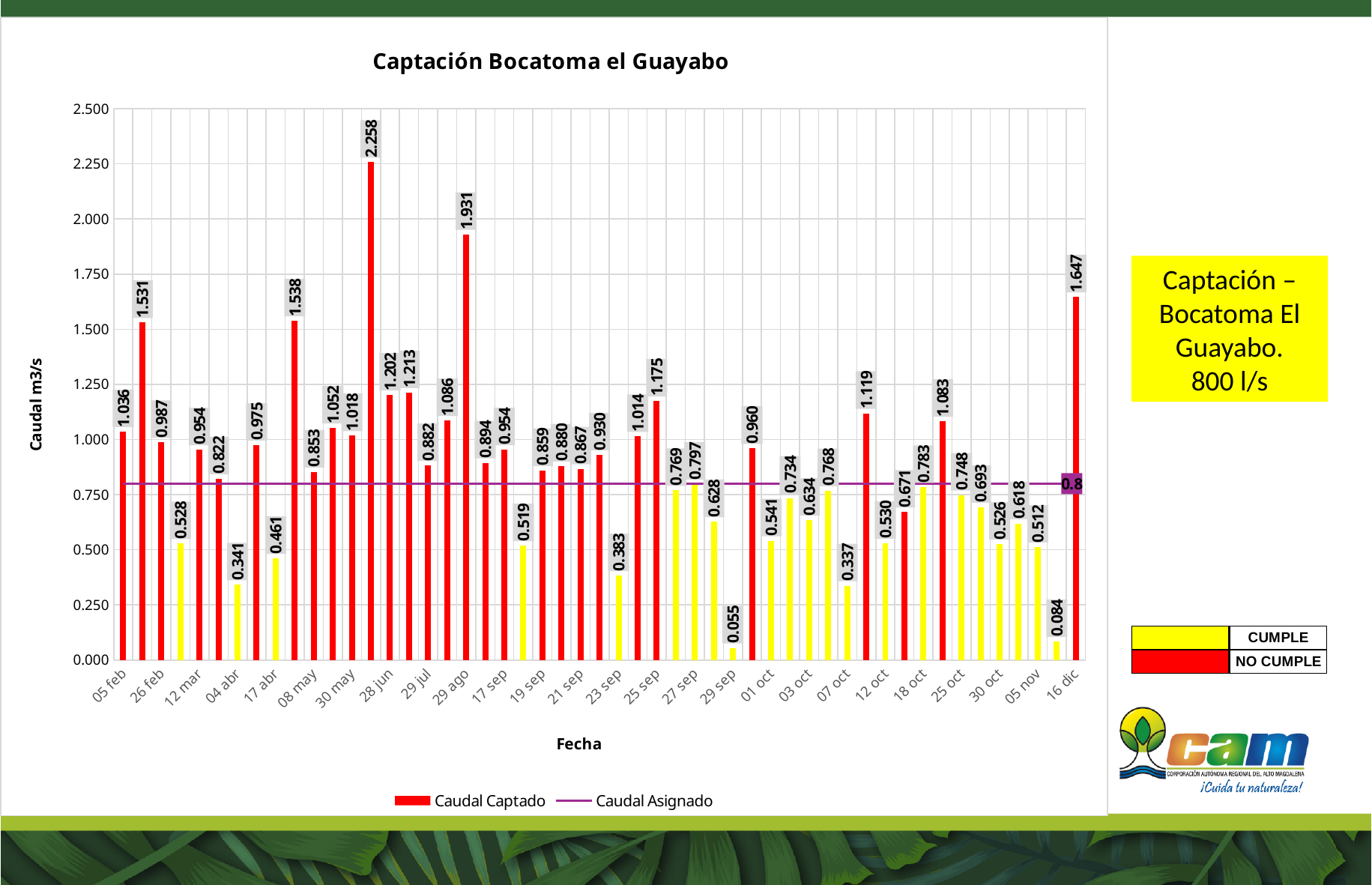
Which labelled date has the lowest Caudal Captado value? 29 sep Is the Caudal Captado value for 04 abr greater or less than 0.500? less What is the value of Caudal Captado for 05 feb? 1.036 What is the value of Caudal Captado for 29 ago? 1.931 What is the highest Caudal Captado value shown on the chart? 2.258 What is the value of the Caudal Asignado line? 0.8 Which has a larger Caudal Captado value, 25 sep or 12 oct? 25 sep What type of chart is shown on the slide? Combination bar and line chart What is the value of Caudal Captado for 07 oct? 0.337 What is the difference between the Caudal Captado values for 16 dic and 05 feb? 0.611 What is the value of Caudal Captado for 16 dic? 1.647 How many series does the legend list? 2